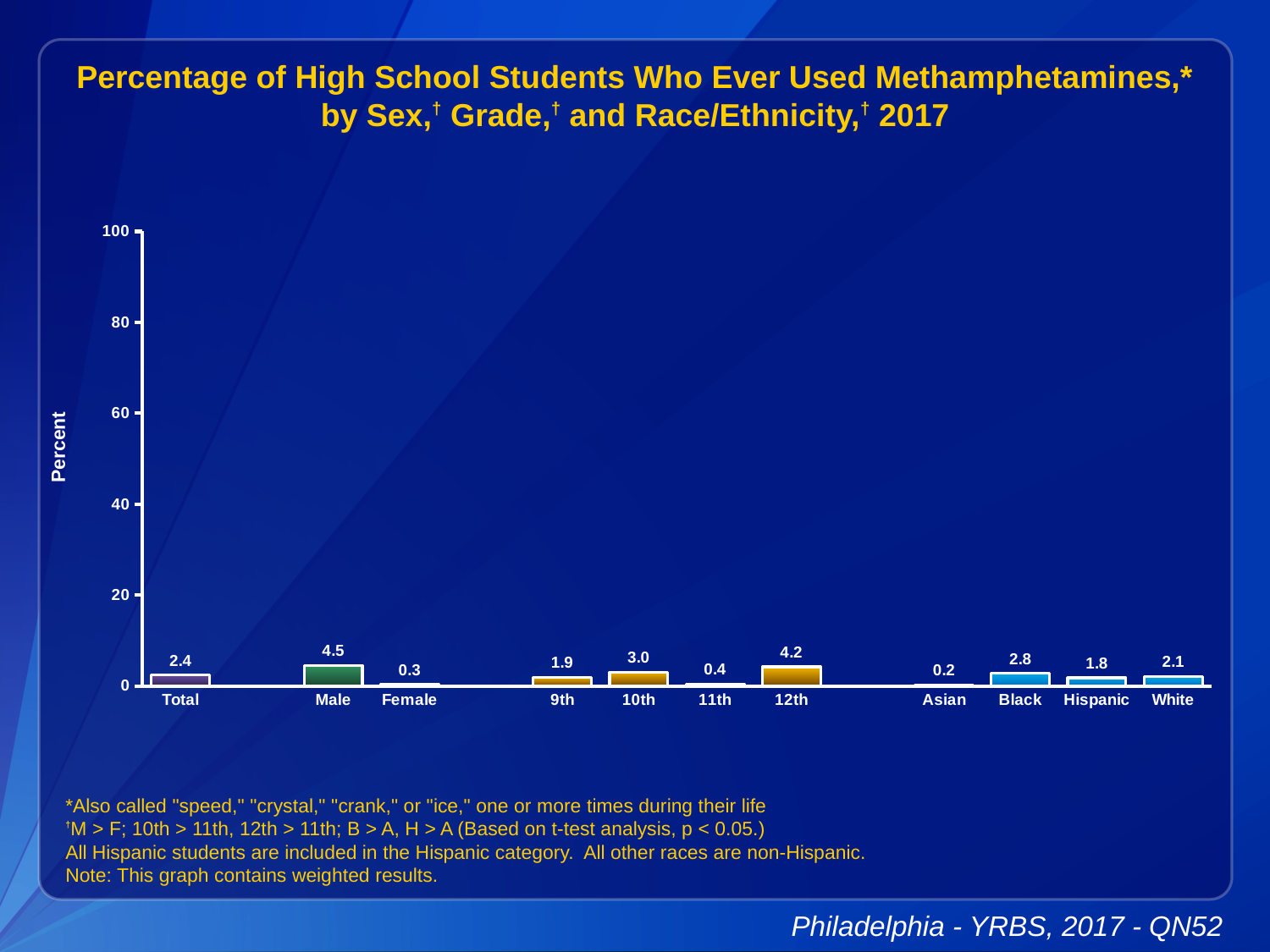
Which category has the highest value? Male What is the value for Male? 4.5 What is the value for 12th grade? 4.2 What is the difference between the values for 12th and 11th grade? 3.8 What is the value for Hispanic students? 1.8 Which category has the lowest value? Asian What is the difference between the values for Male and Female? 4.2 How many categories are shown on the x axis? 11 Which is larger, the value for Black or the value for White? Black What is the value for Total? 2.4 What kind of chart is this? bar chart Is the value for 10th grade greater or less than 20? less